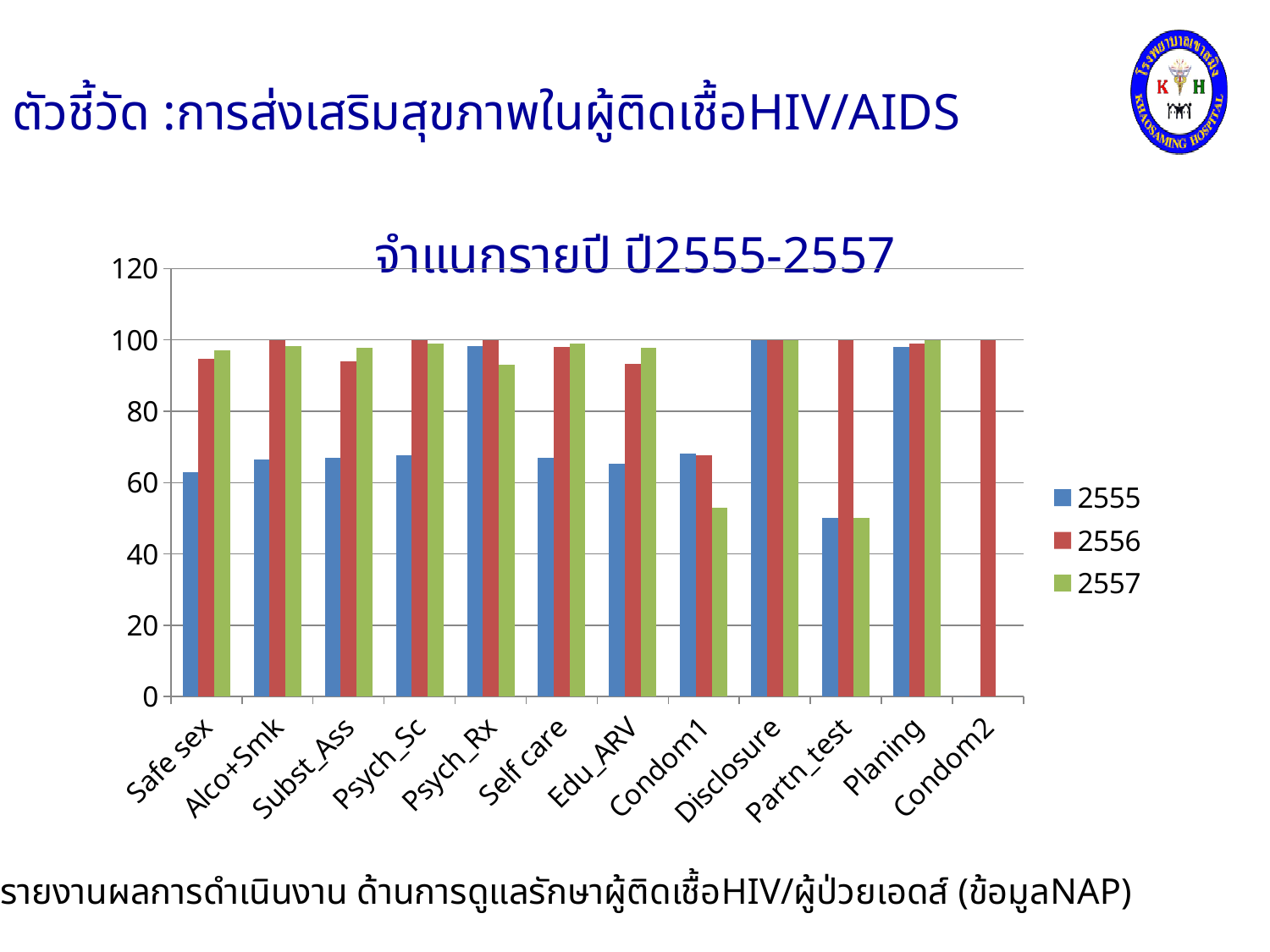
Is the value for Condom1 in the 2557 series greater or less than 40? greater What is the value for Condom2 in the 2556 series? 100 Which category has no bars for the 2555 and 2557 series? Condom2 How many series does the legend list? 3 How many categories are shown on the x axis? 12 Is the value for Safe sex in the 2555 series greater or less than 80? less What kind of chart is shown on the slide? bar chart What is the value for Disclosure in the 2555 series? 100 What are the three legend entries of the chart? 2555, 2556, 2557 Which is larger for Safe sex: the 2555 value or the 2556 value? 2556